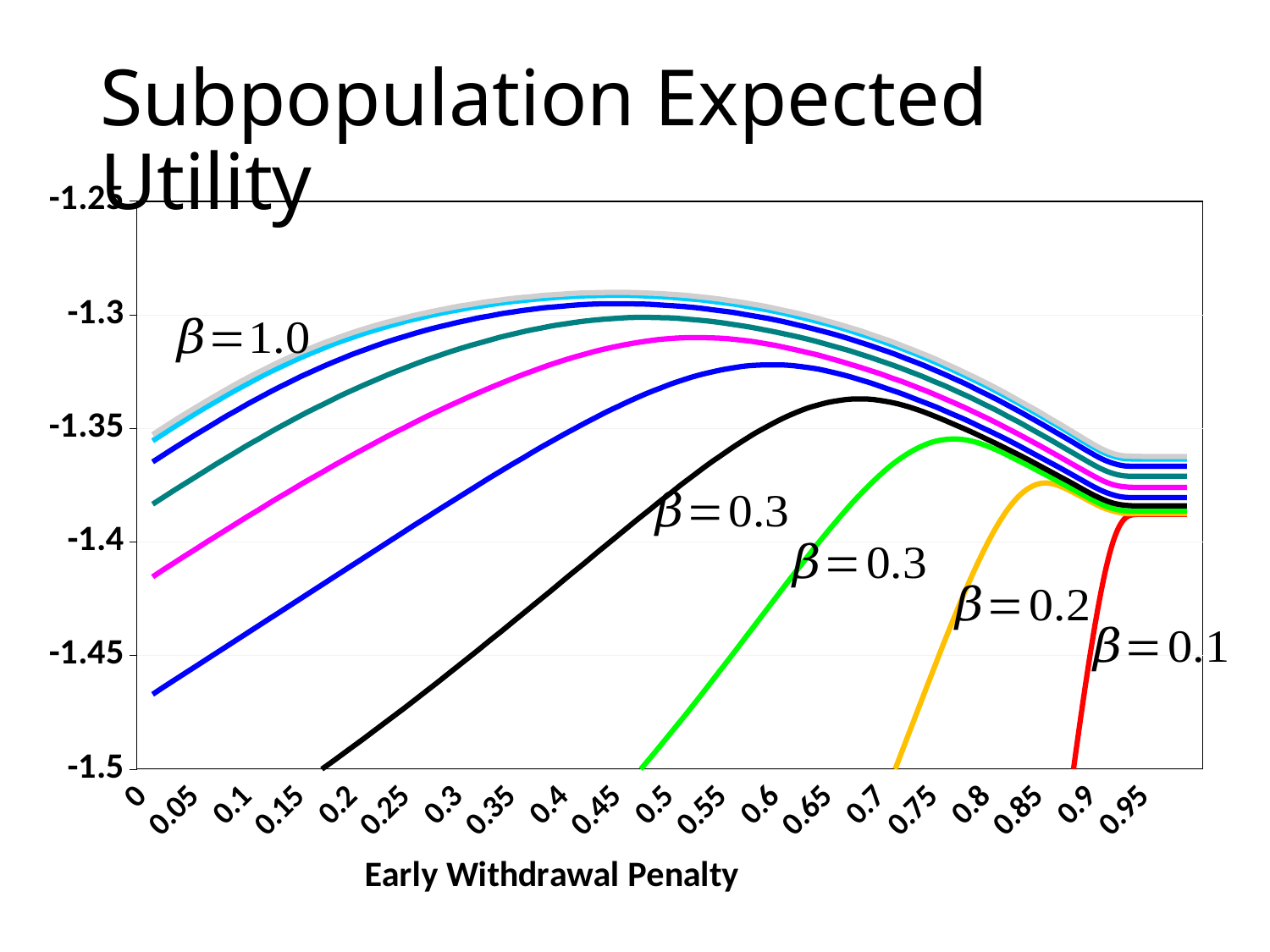
Is the value of the black β=0.3 curve at an early withdrawal penalty of 0.4 greater or less than -1.4? less Does the β=1.0 curve rise or fall between early withdrawal penalties of 0.5 and 0.9? fall Is the value of the magenta curve at an early withdrawal penalty of 0 greater or less than -1.4? less Is the value of the β=1.0 curve at an early withdrawal penalty of 0.45 greater or less than -1.3? greater How many tick labels are shown on the x axis? 20 What kind of chart is shown on the slide? Line chart Which curve has the highest value at an early withdrawal penalty of 0? β=1.0 At an early withdrawal penalty of 0.5, which is higher: the magenta curve or the black β=0.3 curve? magenta curve What is the title of the chart? Subpopulation Expected Utility Does the red β=0.1 curve rise or fall between early withdrawal penalties of 0.9 and 0.95? rise What is the label of the x axis? Early Withdrawal Penalty